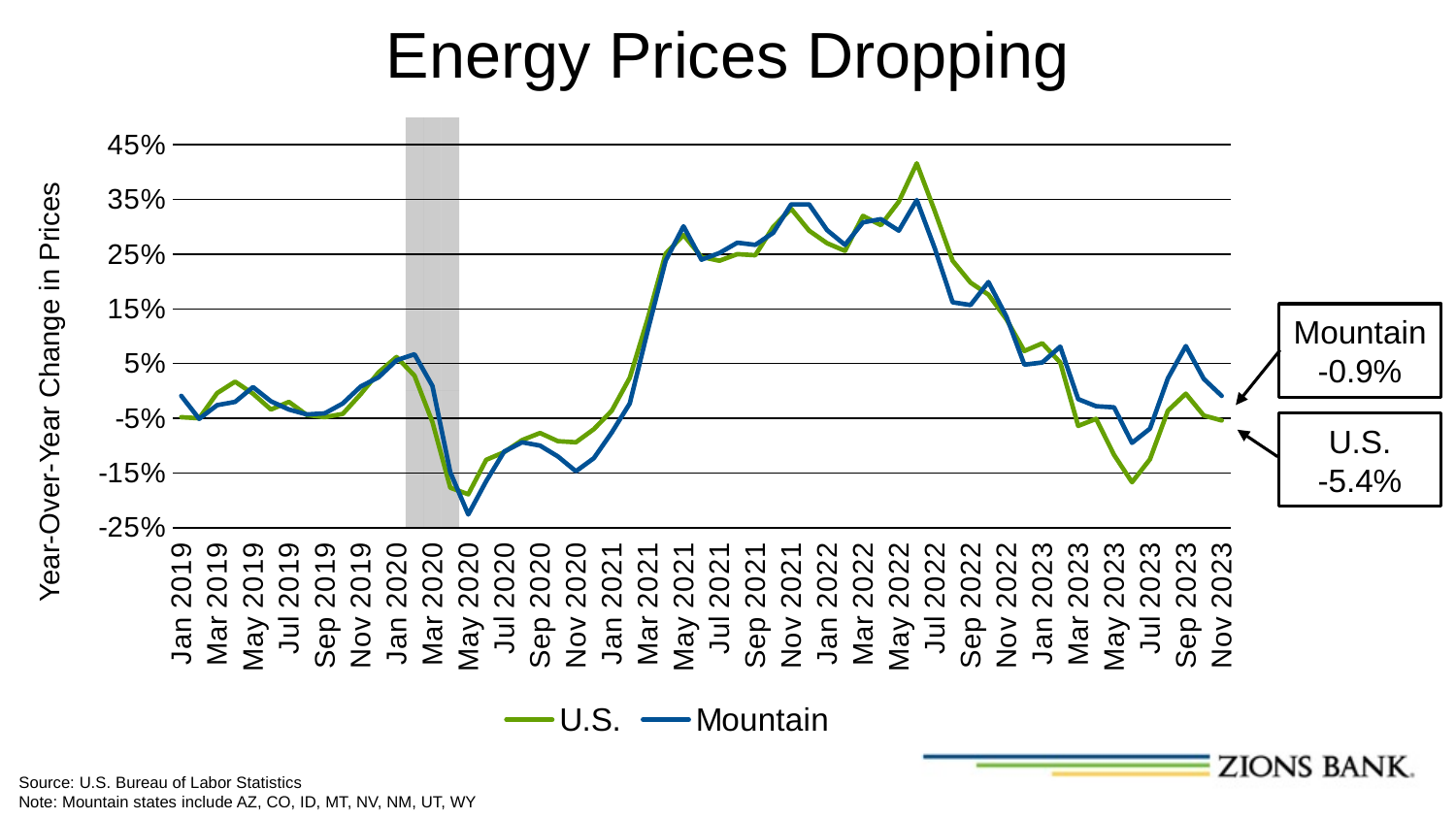
What is the U.S. year-over-year change in energy prices for Nov 2023? -5.4% In Nov 2023, which series has the higher value, U.S. or Mountain? Mountain What is the Mountain year-over-year change in energy prices for Nov 2023? -0.9% Is the lowest value reached by the Mountain line greater or less than -15%? less How many series does the legend list? 2 Which series reaches the higher peak value in 2022? U.S. Does the U.S. line rise or fall between mid-2022 and mid-2023? fall Is the highest value reached by the U.S. line greater or less than 35%? greater What is the title of the chart? Energy Prices Dropping What is the label on the vertical axis? Year-Over-Year Change in Prices What kind of chart is shown on the slide? line chart What is the difference between the Mountain and U.S. values labeled for Nov 2023? 4.5 percentage points